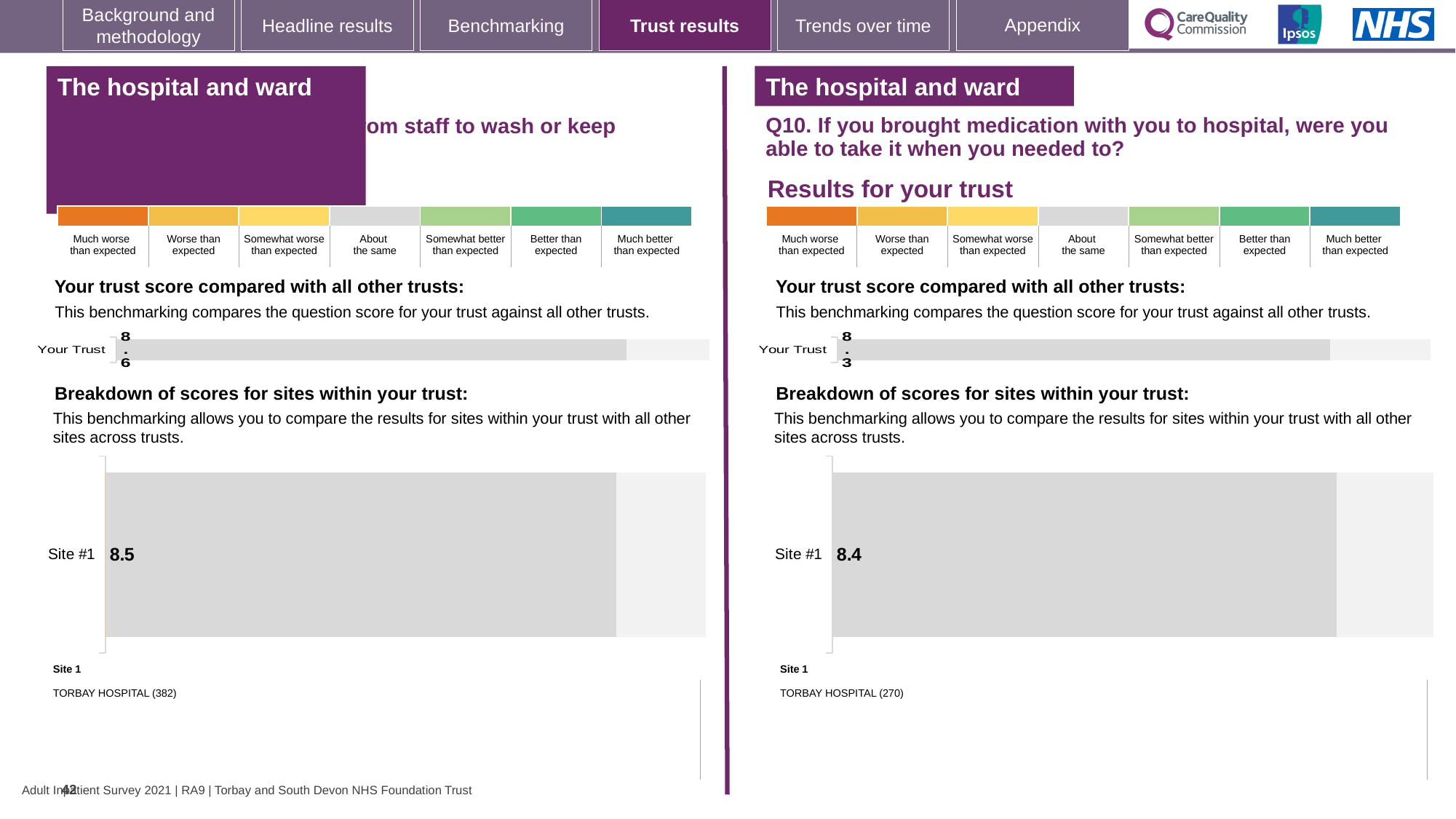
In the right-hand 'Breakdown of scores for sites within your trust' chart (Q10), what is the score for Site #1? 8.4 What is the difference between the 'Your Trust' score on the left half of the slide (8.6) and the 'Your Trust' score on the right half (8.3)? 0.3 Which is larger: the Site #1 score in the left-hand site breakdown chart or the Site #1 score in the right-hand site breakdown chart? Left-hand (8.5) On the left half of the slide, what is the 'Your Trust' score shown in the trust benchmarking bar? 8.6 How many sites are plotted in the left-hand 'Breakdown of scores for sites within your trust' chart? 1 What type of chart is used for the 'Breakdown of scores for sites within your trust' on the right half of the slide? Bar chart On the right half of the slide (Q10, medication), what is the 'Your Trust' score shown in the trust benchmarking bar? 8.3 What is the difference between the Site #1 score in the right-hand site breakdown chart and the 'Your Trust' score on the right half of the slide? 0.1 Which hospital is listed as Site 1 in the right-hand site breakdown, and how many respondents are shown in brackets? TORBAY HOSPITAL (270) How many respondents are shown in brackets for Site 1 (TORBAY HOSPITAL) in the left-hand site breakdown? 382 In the left-hand 'Breakdown of scores for sites within your trust' chart, what is the score for Site #1? 8.5